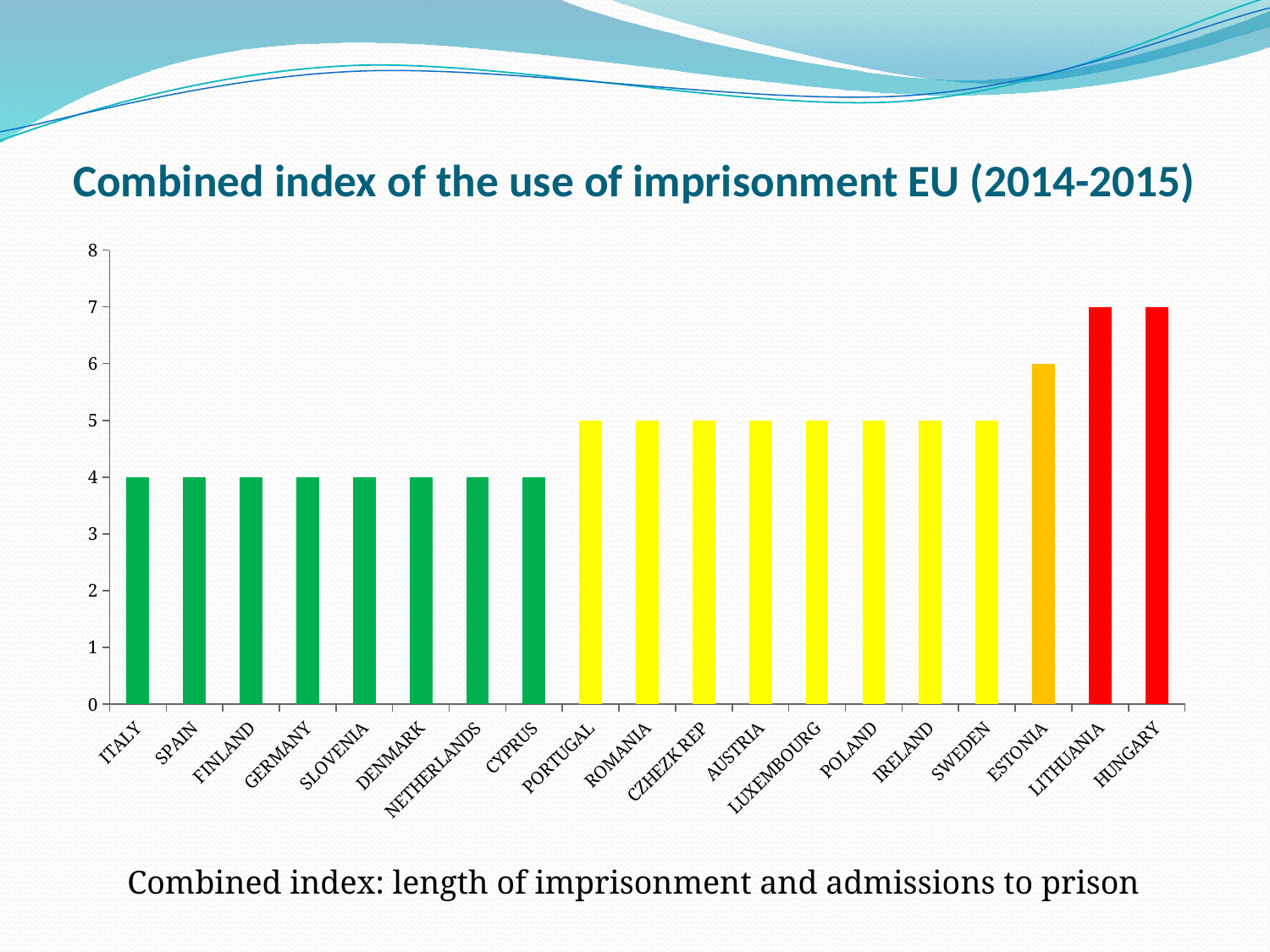
What is the difference between the values for Estonia and Sweden? 1 What kind of chart is shown on the slide? Bar chart What is the value for Portugal? 5 Which countries have the highest value on the chart? Lithuania and Hungary How many countries are shown on the chart? 19 What is the difference between the values for Hungary and Italy? 3 What is the value for Italy? 4 What is the value for Estonia? 6 What is the value for Hungary? 7 Which has a larger value, Estonia or Sweden? Estonia Do the values rise or fall from left to right along the x axis? Rise Is the value for Lithuania greater or less than 6? greater